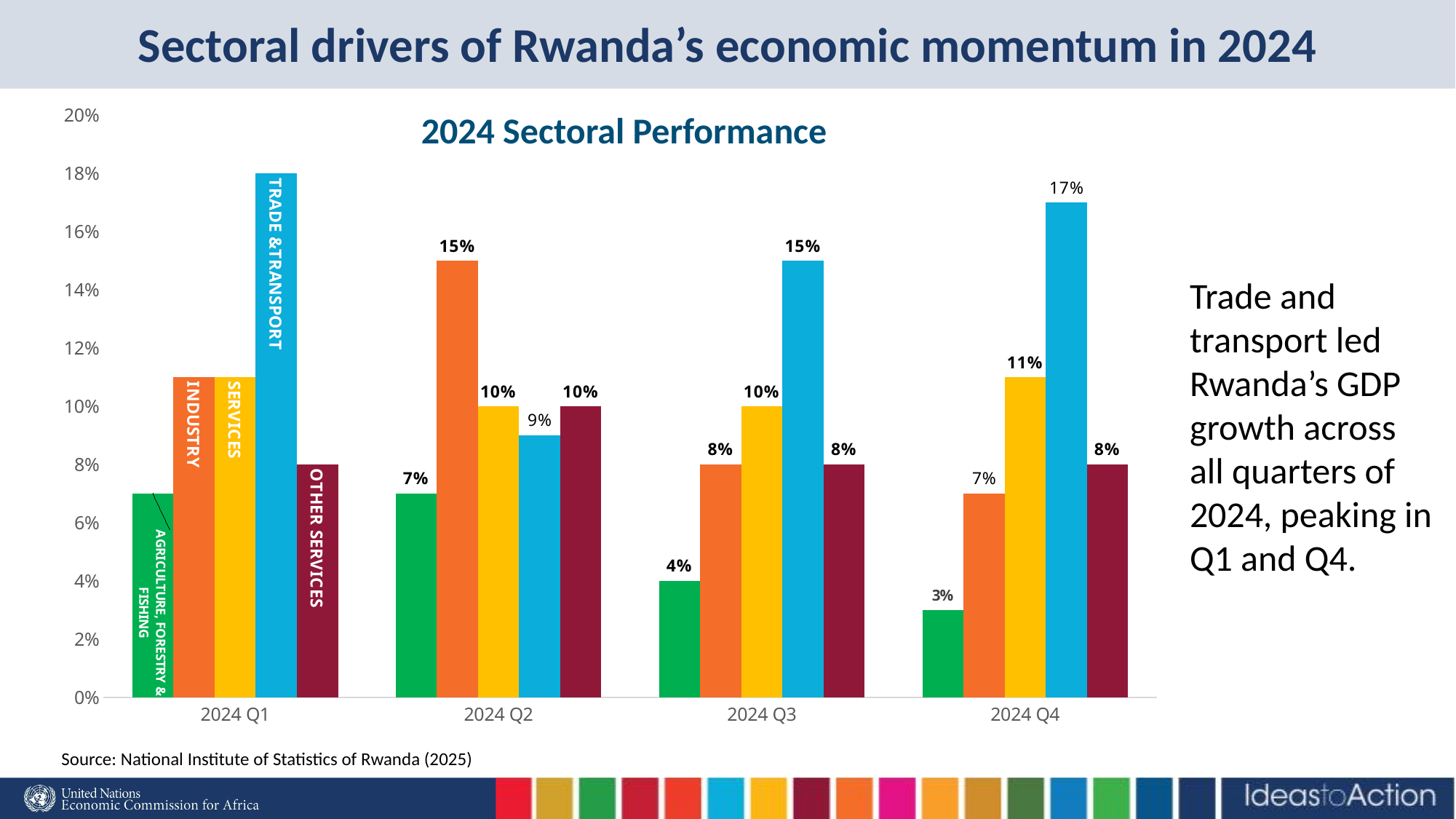
In 2024 Q2, how much higher is Industry than Agriculture, Forestry & Fishing? 8 percentage points What is the value for Industry in 2024 Q2? 15% Which sector has the highest value in 2024 Q3? Trade & Transport How many quarters are shown along the x axis? 4 What is the value for Trade & Transport in 2024 Q4? 17% In 2024 Q3, which is larger: Services or Other Services? Services Is the value for Industry in 2024 Q1 greater or less than 10%? greater What is the value for Agriculture, Forestry & Fishing in 2024 Q4? 3% What kind of chart is shown on the slide? Bar chart What is the title of the chart? 2024 Sectoral Performance How many sectors are plotted for each quarter? 5 Which sector has the lowest value in 2024 Q4? Agriculture, Forestry & Fishing